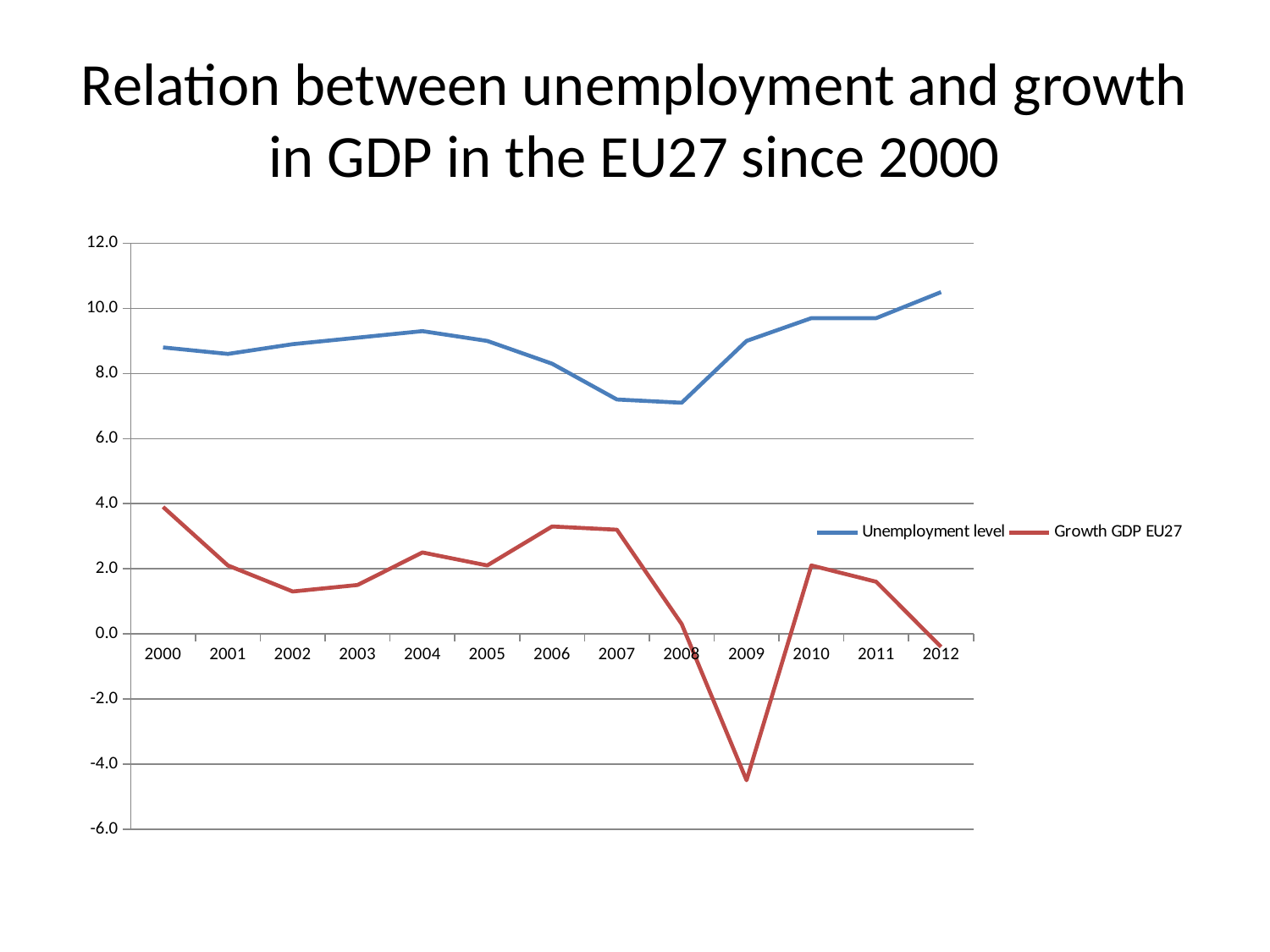
In which year is the Growth GDP EU27 series at its highest? 2000 What kind of chart is shown on the slide? Line chart Does the Unemployment level series rise or fall from 2008 to 2012? Rise What is the title of the slide? Relation between unemployment and growth in GDP in the EU27 since 2000 In which year is the Growth GDP EU27 series at its lowest? 2009 Is the Growth GDP EU27 value for 2009 greater or less than -4.0? less In which year is the Unemployment level series at its highest? 2012 How many years are plotted along the x axis? 13 Which is larger, the Unemployment level in 2010 or in 2008? 2010 Is the Unemployment level value for 2008 greater or less than 8.0? less How many series does the legend list? 2 Is the Unemployment level value for 2012 greater or less than 10.0? greater